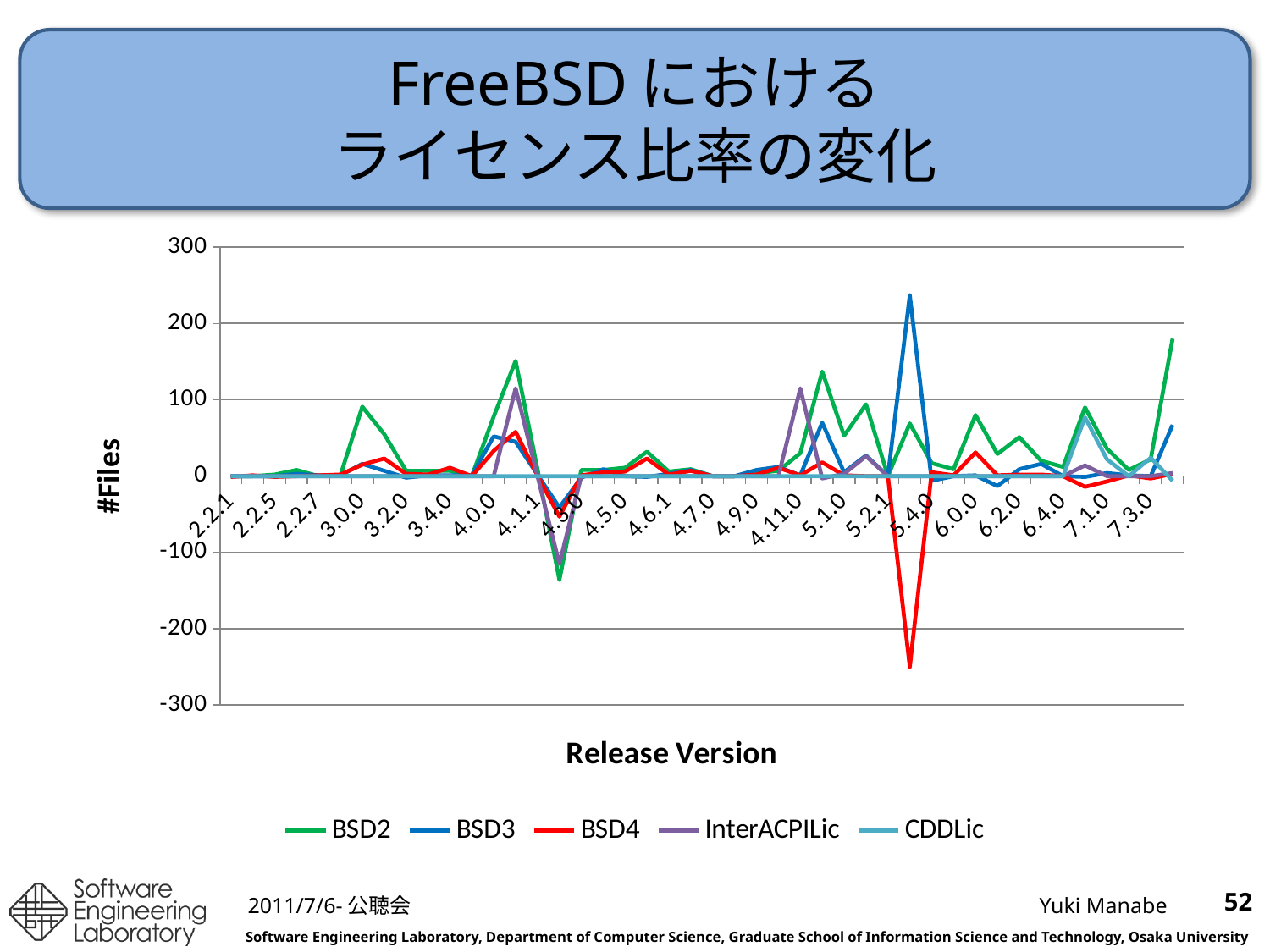
What kind of chart is shown on the slide? line chart Which series is drawn in red? BSD4 What is the title of the vertical axis? #Files Which series reaches the lowest value anywhere on the chart? BSD4 How many series does the legend list? 5 Which series reaches the highest value anywhere on the chart? BSD3